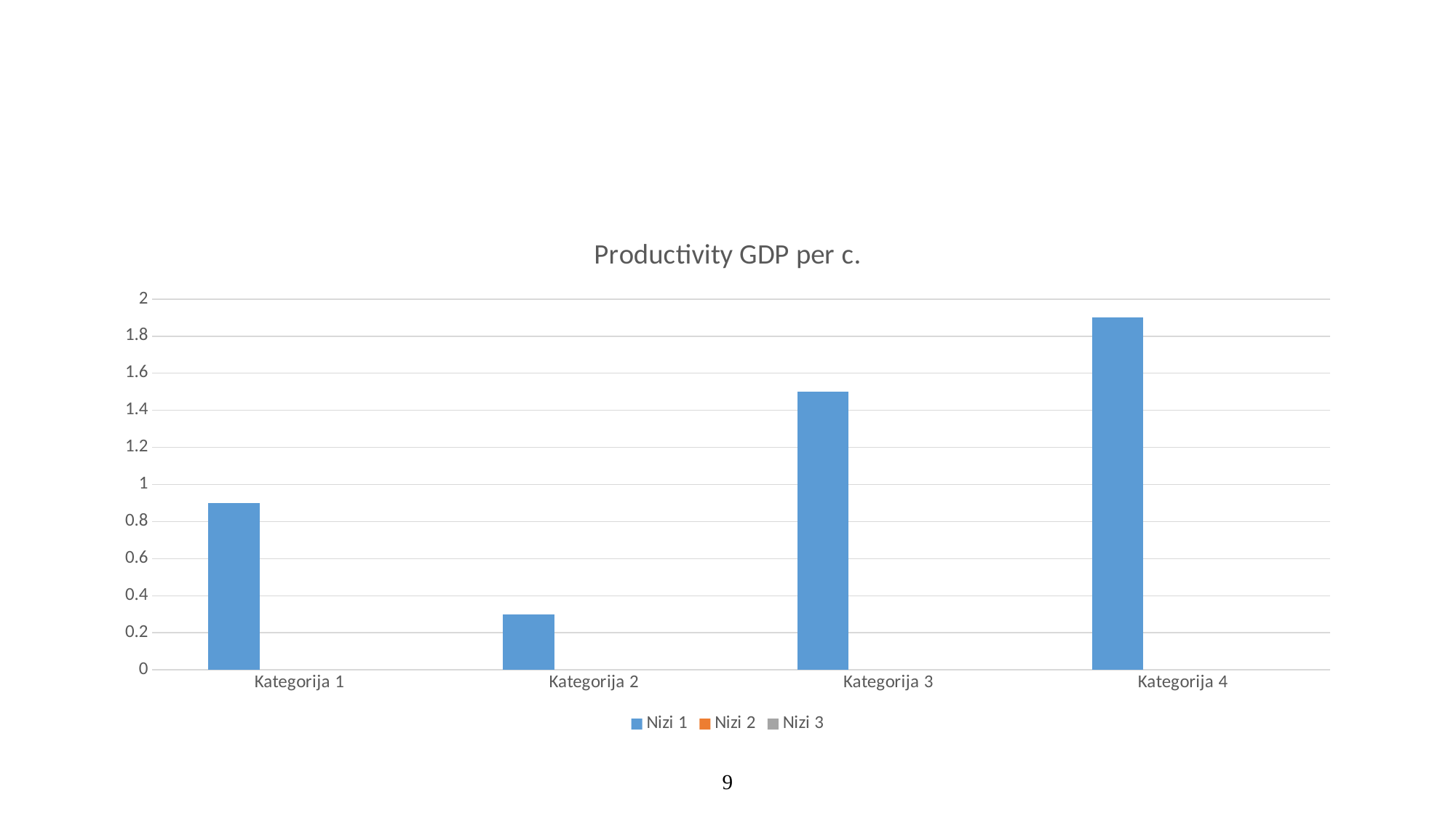
Is the value for Kategorija 4 greater or less than 1.8? greater How many categories are shown on the x axis of the chart? 4 How many series does the legend list? 3 What is the title of the chart? Productivity GDP per c. Which category has the highest bar? Kategorija 4 Is the value for Kategorija 1 greater or less than 1? less Which series in the legend is shown in blue? Nizi 1 Which is larger, the value for Kategorija 3 or the value for Kategorija 1? Kategorija 3 What kind of chart is shown on the slide? bar chart Which is larger, the value for Kategorija 1 or the value for Kategorija 2? Kategorija 1 Is the value for Kategorija 2 greater or less than 0.4? less Which category has the lowest bar? Kategorija 2